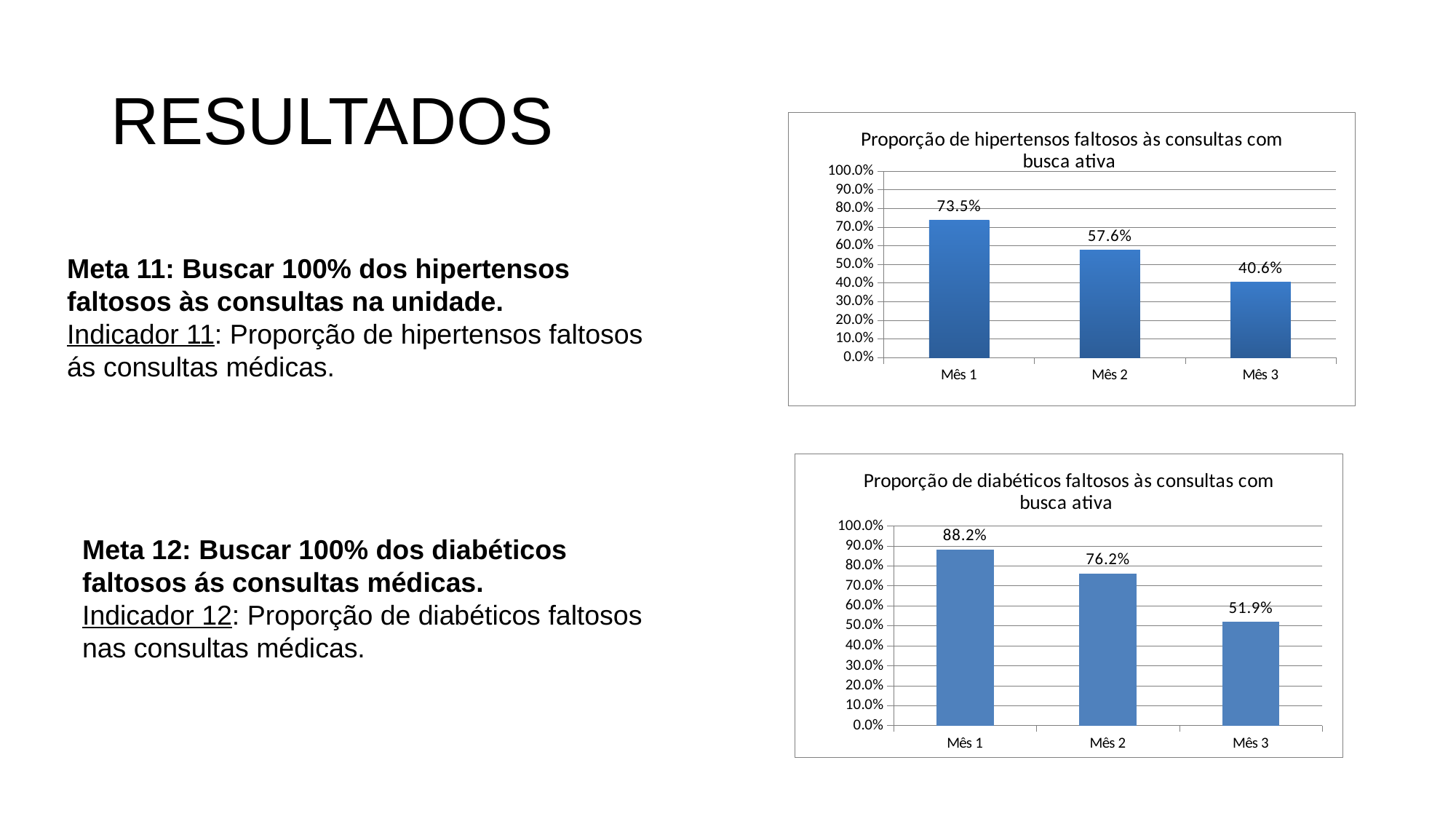
How many months are shown on the x axis of the bottom chart (Proporção de diabéticos faltosos às consultas com busca ativa)? 3 In the top chart (Proporção de hipertensos faltosos às consultas com busca ativa), which month has the lowest value? Mês 3 In the bottom chart (Proporção de diabéticos faltosos às consultas com busca ativa), do the values rise or fall from Mês 1 to Mês 3? Fall In the top chart (Proporção de hipertensos faltosos às consultas com busca ativa), what is the value for Mês 1? 73.5% In the top chart (Proporção de hipertensos faltosos às consultas com busca ativa), what is the value for Mês 3? 40.6% In the bottom chart (Proporção de diabéticos faltosos às consultas com busca ativa), what is the value for Mês 2? 76.2% In the bottom chart (Proporção de diabéticos faltosos às consultas com busca ativa), what is the difference between the values for Mês 2 and Mês 3? 24.3% What kind of chart is the top chart (Proporção de hipertensos faltosos às consultas com busca ativa)? Bar chart In the bottom chart (Proporção de diabéticos faltosos às consultas com busca ativa), which month has the highest value? Mês 1 In the top chart (Proporção de hipertensos faltosos às consultas com busca ativa), what is the difference between the values for Mês 1 and Mês 2? 15.9% In the bottom chart (Proporção de diabéticos faltosos às consultas com busca ativa), which is larger, the value for Mês 1 or Mês 3? Mês 1 In the top chart (Proporção de hipertensos faltosos às consultas com busca ativa), is the value for Mês 2 greater or less than 50.0%? greater